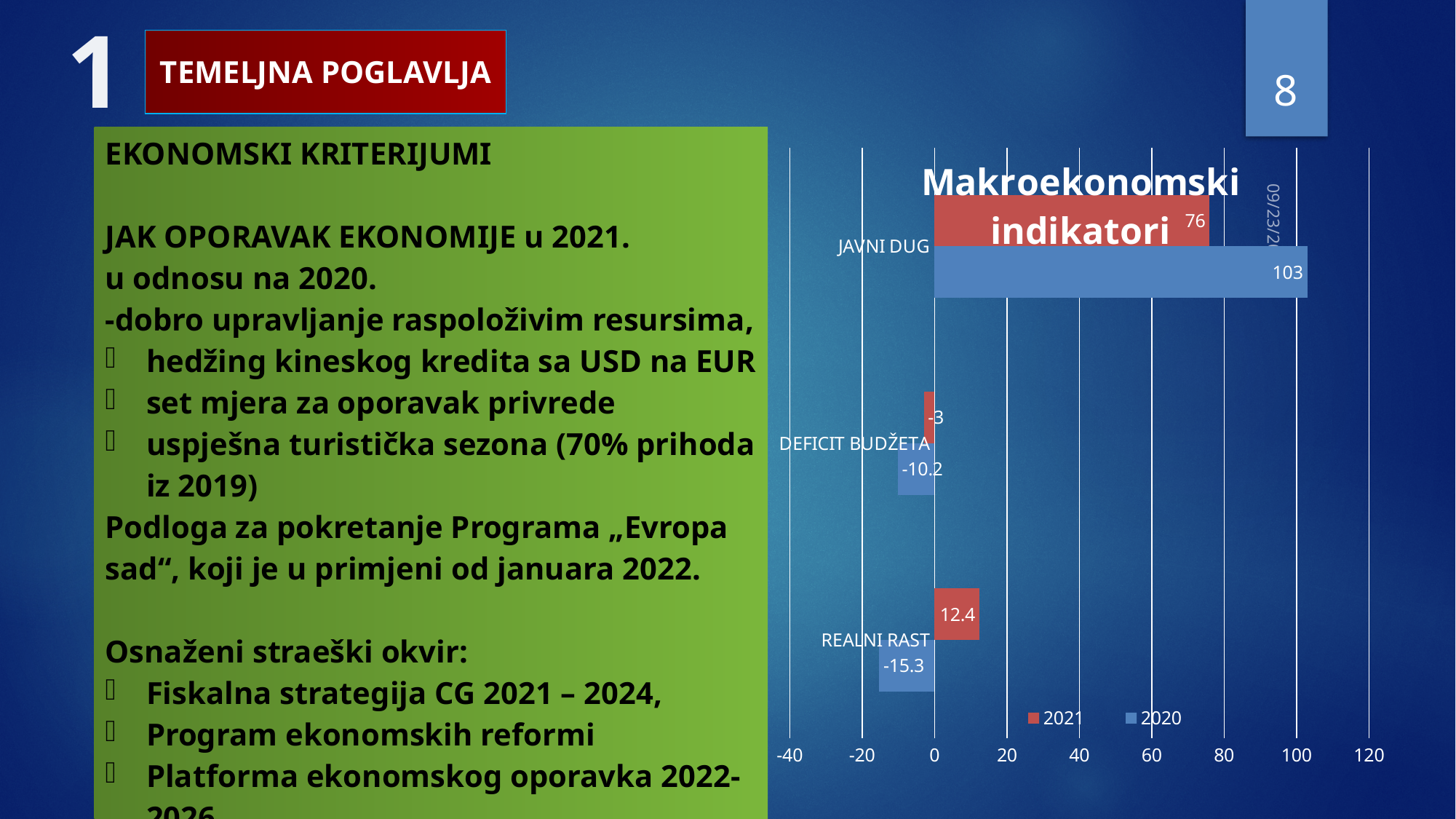
Which category has the lowest value in the 2020 series? REALNI RAST How many series does the legend list? 2 What is the difference between the 2020 and 2021 values for JAVNI DUG? 27 What type of chart is shown? Bar chart What is the value for REALNI RAST in the 2020 series? -15.3 What is the value for JAVNI DUG in the 2021 series? 76 What is the value for JAVNI DUG in the 2020 series? 103 What is the value for DEFICIT BUDŽETA in the 2020 series? -10.2 What is the value for DEFICIT BUDŽETA in the 2021 series? -3 Which category has the highest value in the 2020 series? JAVNI DUG Which is larger for REALNI RAST, the 2021 value or the 2020 value? 2021 What is the value for REALNI RAST in the 2021 series? 12.4